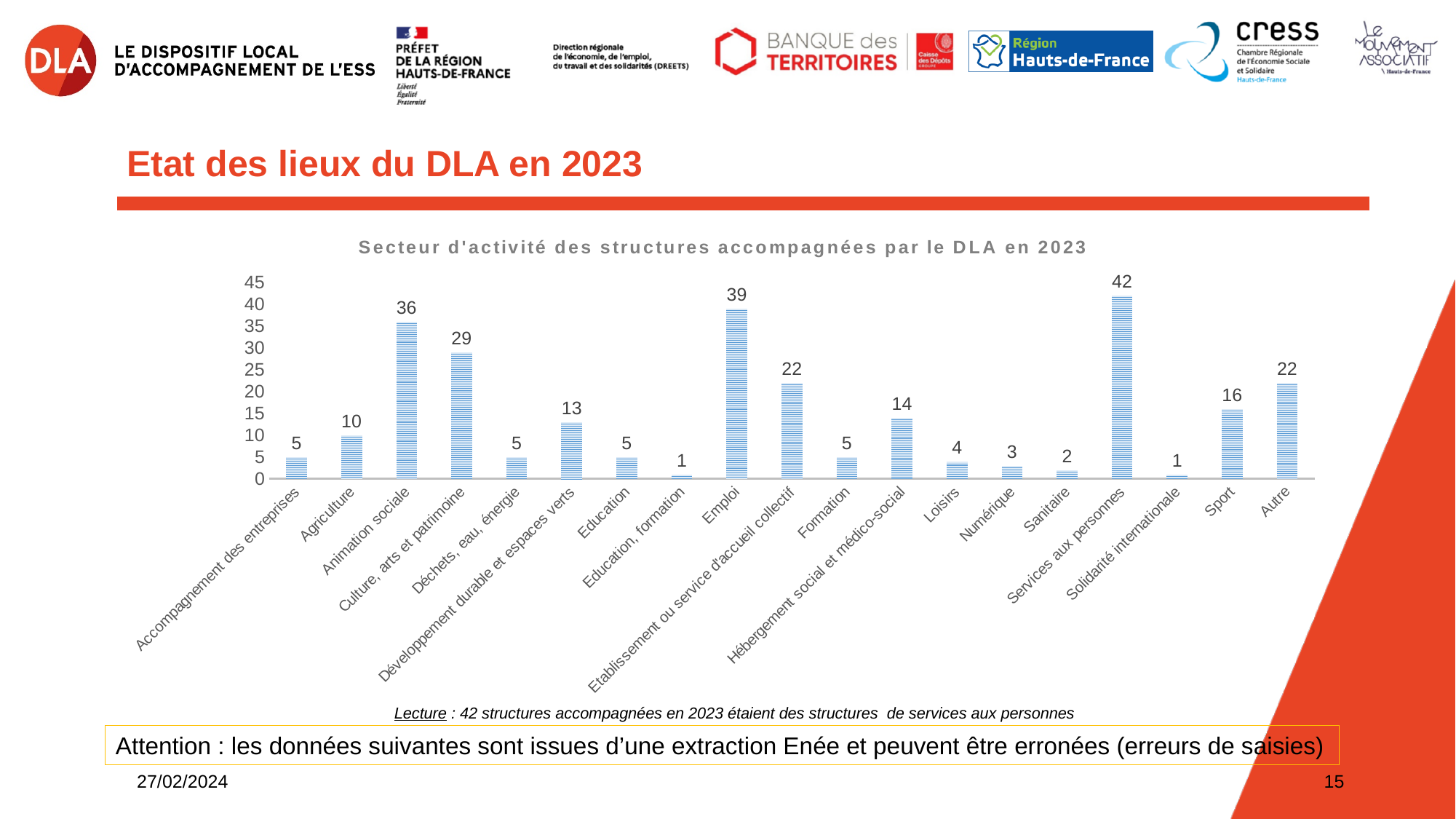
What is the value for Services aux personnes? 42 What is the value for Culture, arts et patrimoine? 29 What is the title of the chart? Secteur d'activité des structures accompagnées par le DLA en 2023 What is the difference between the values for Services aux personnes and Emploi? 3 What is the value for Emploi? 39 How many sector categories are shown on the x axis? 19 Which sector has the highest value? Services aux personnes Is the value for Animation sociale greater or less than 30? greater What is the value for Hébergement social et médico-social? 14 What kind of chart is shown on the slide? bar chart Which is larger, the value for Sport or the value for Autre? Autre What is the difference between the values for Animation sociale and Agriculture? 26